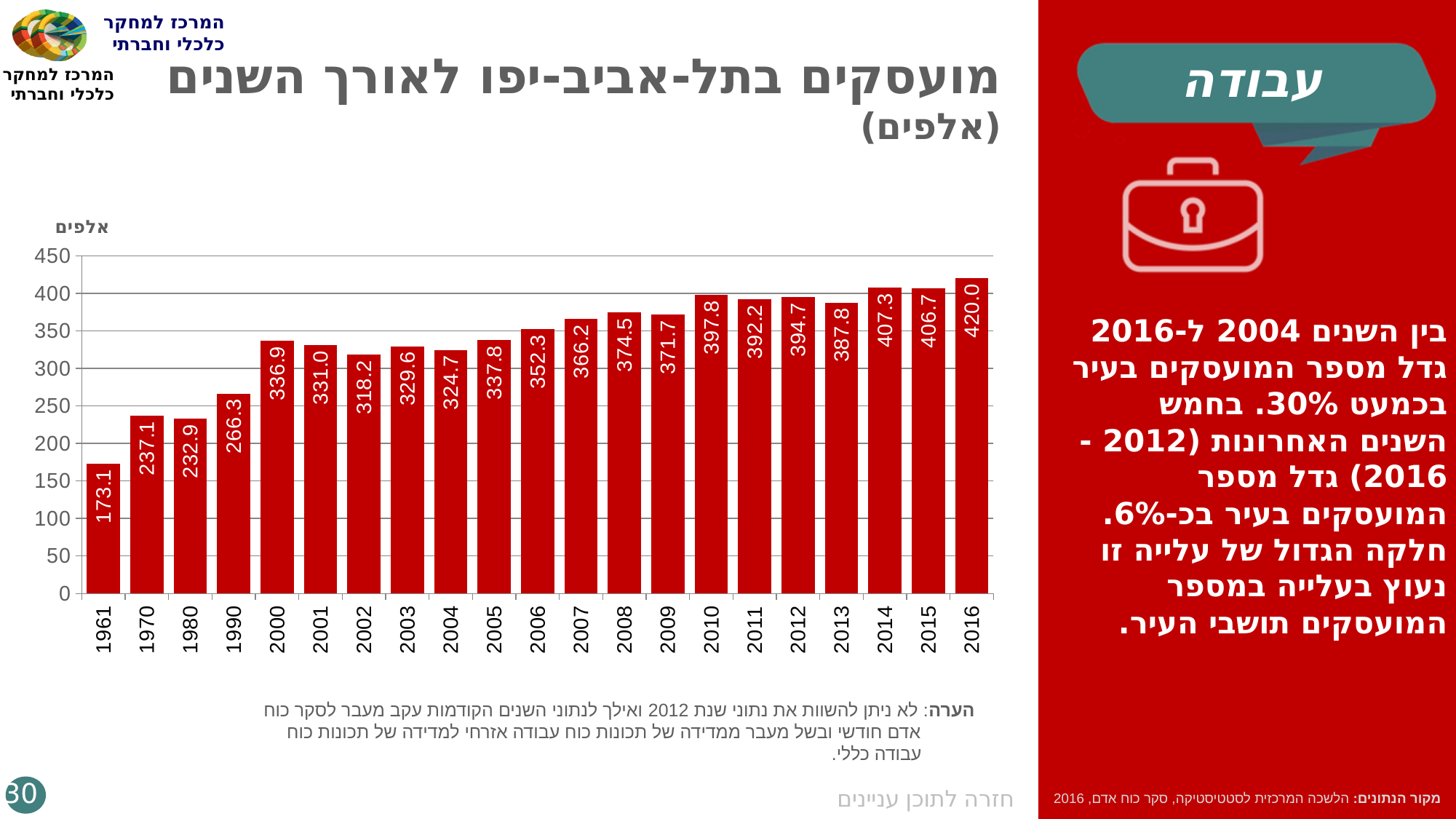
What kind of chart is shown on the slide? bar chart What colour are the bars in the chart? red What is the difference between the values for 2016 and 2004? 95.3 What is the value for 2004? 324.7 What is the value for 2016? 420.0 Which is larger, the value for 2010 or the value for 2011? 2010 Is the value for 2014 greater or less than 400? greater Do the values generally rise or fall from 2004 to 2016? rise What is the value for 1961? 173.1 How many years are shown on the x axis? 21 Which year has the highest value? 2016 Which year has the lowest value? 1961